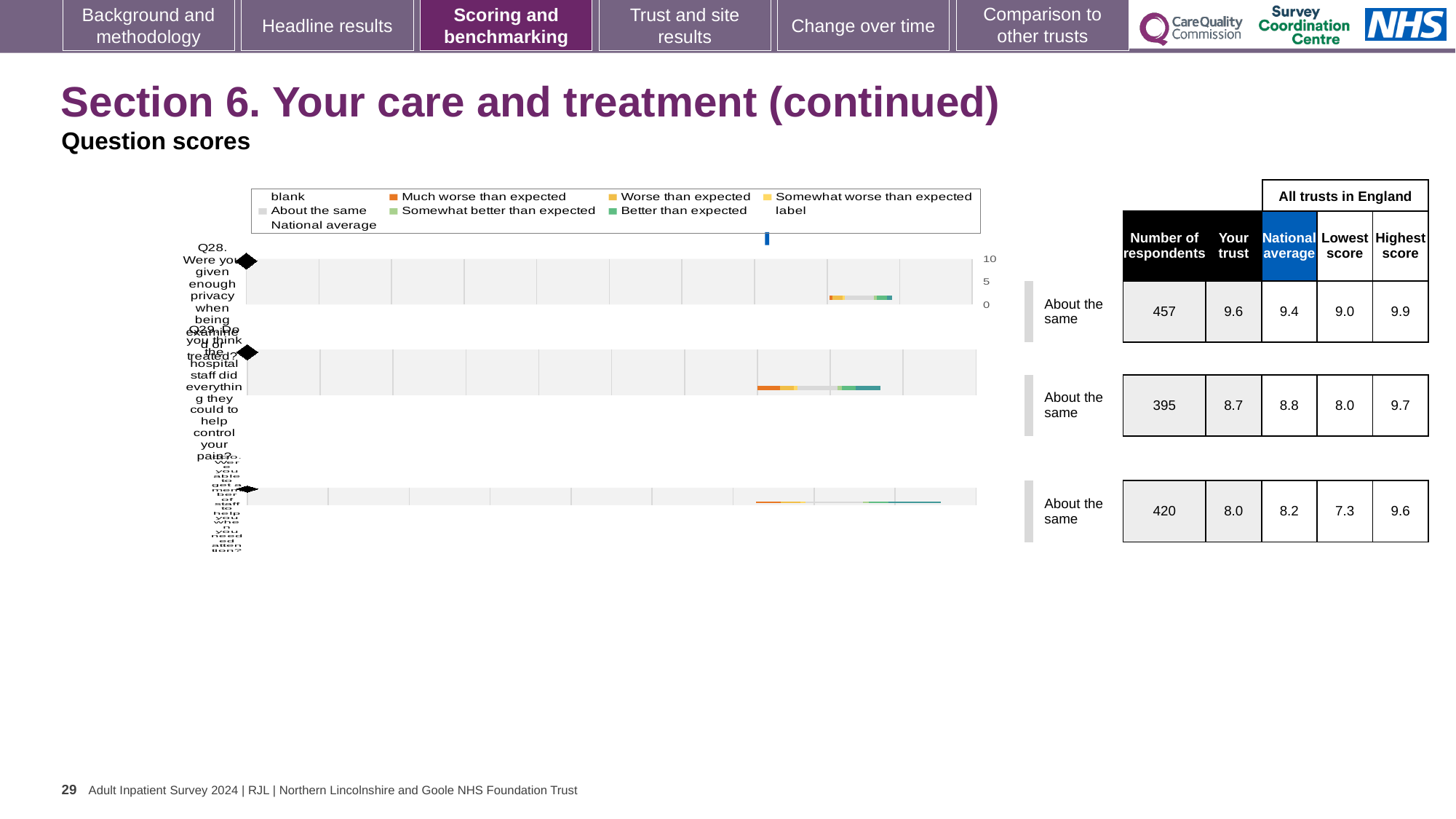
For the Q29 chart (help to control your pain), which is higher: the 'Your trust' score or the national average? National average For the Q28 chart (privacy when being examined or treated), what is the national average score? 9.4 For the bottom chart (Q30), what is the lowest score among all trusts in England? 7.3 How many entries does the legend above the charts list? 9 What benchmark label is shown next to each of the three charts? About the same What kind of chart is used for the Q28 privacy question? Bar chart How many question charts are shown on the slide? 3 Which of the three question charts has the highest 'Your trust' score? Q28 For the Q29 chart (help to control your pain), how many respondents are there? 395 For the Q28 chart, is the 'Your trust' score greater or less than 5? greater For the Q28 chart (privacy when being examined or treated), what is the 'Your trust' score? 9.6 For the Q28 chart (privacy when being examined or treated), what is the difference between the highest score and the lowest score across all trusts in England? 0.9